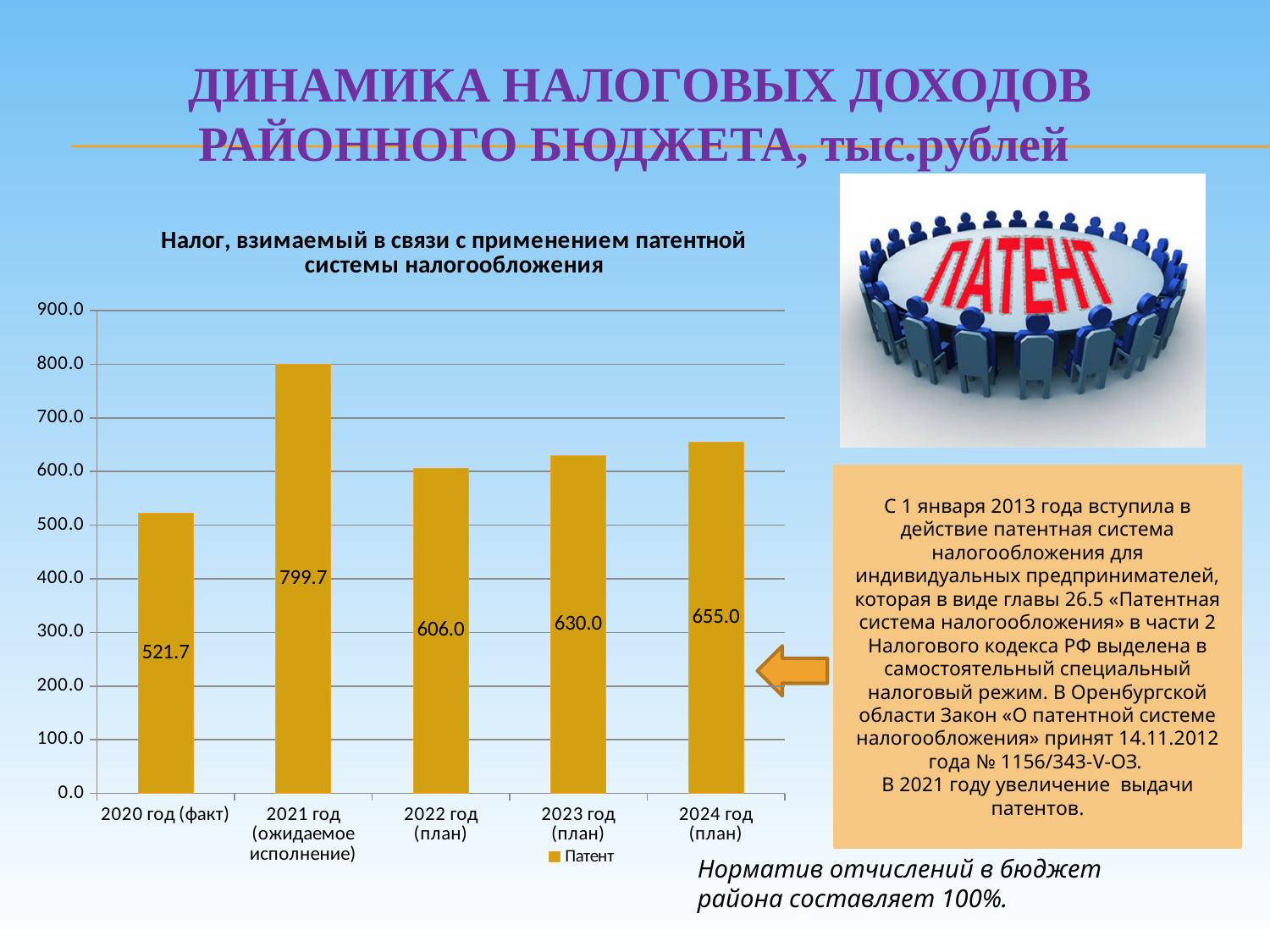
How many categories are shown on the x axis? 5 What is the value for 2020 год (факт)? 521.7 What is the difference between the values for 2021 год (ожидаемое исполнение) and 2020 год (факт)? 278.0 What is the difference between the values for 2024 год (план) and 2023 год (план)? 25.0 What kind of chart is shown? bar chart What is the value for 2021 год (ожидаемое исполнение)? 799.7 Which year has the lowest value? 2020 год (факт) Is the value for 2022 год (план) greater or less than 700.0? less What series name does the legend show? Патент Which year has the highest value? 2021 год (ожидаемое исполнение) Which is larger, the value for 2022 год (план) or 2023 год (план)? 2023 год (план) What is the value for 2024 год (план)? 655.0